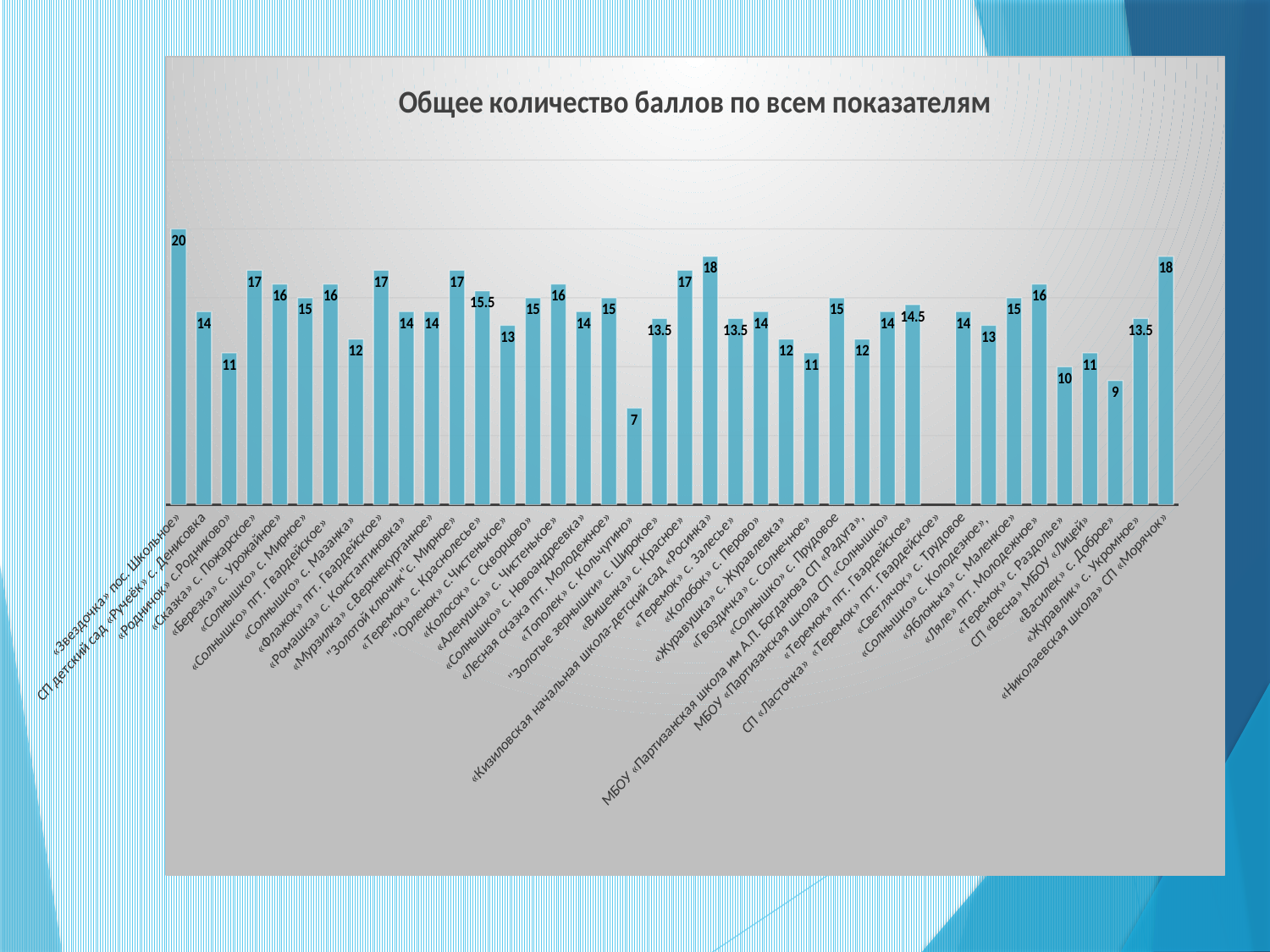
What type of chart is shown on the slide? bar chart What is the value for Николаевская школа СП «Морячок»? 18 Which category has the highest value? «Звездочка» пос. Школьное What is the difference between the values for «Звездочка» пос. Школьное and «Тополек» с. Кольчугино? 13 Which is larger, the value for «Сказка» с. Пожарское or the value for «Родничок» с. Родниково? «Сказка» с. Пожарское Which category has the lowest value? «Тополек» с. Кольчугино What is the difference between the values for Николаевская школа СП «Морячок» and СП детский сад «Ручеёк» с. Денисовка? 4 What is the title of the chart? Общее количество баллов по всем показателям What is the value for «Тополек» с. Кольчугино? 7 What is the value for «Родничок» с. Родниково? 11 What is the value for СП детский сад «Ручеёк» с. Денисовка? 14 What is the value for «Звездочка» пос. Школьное? 20